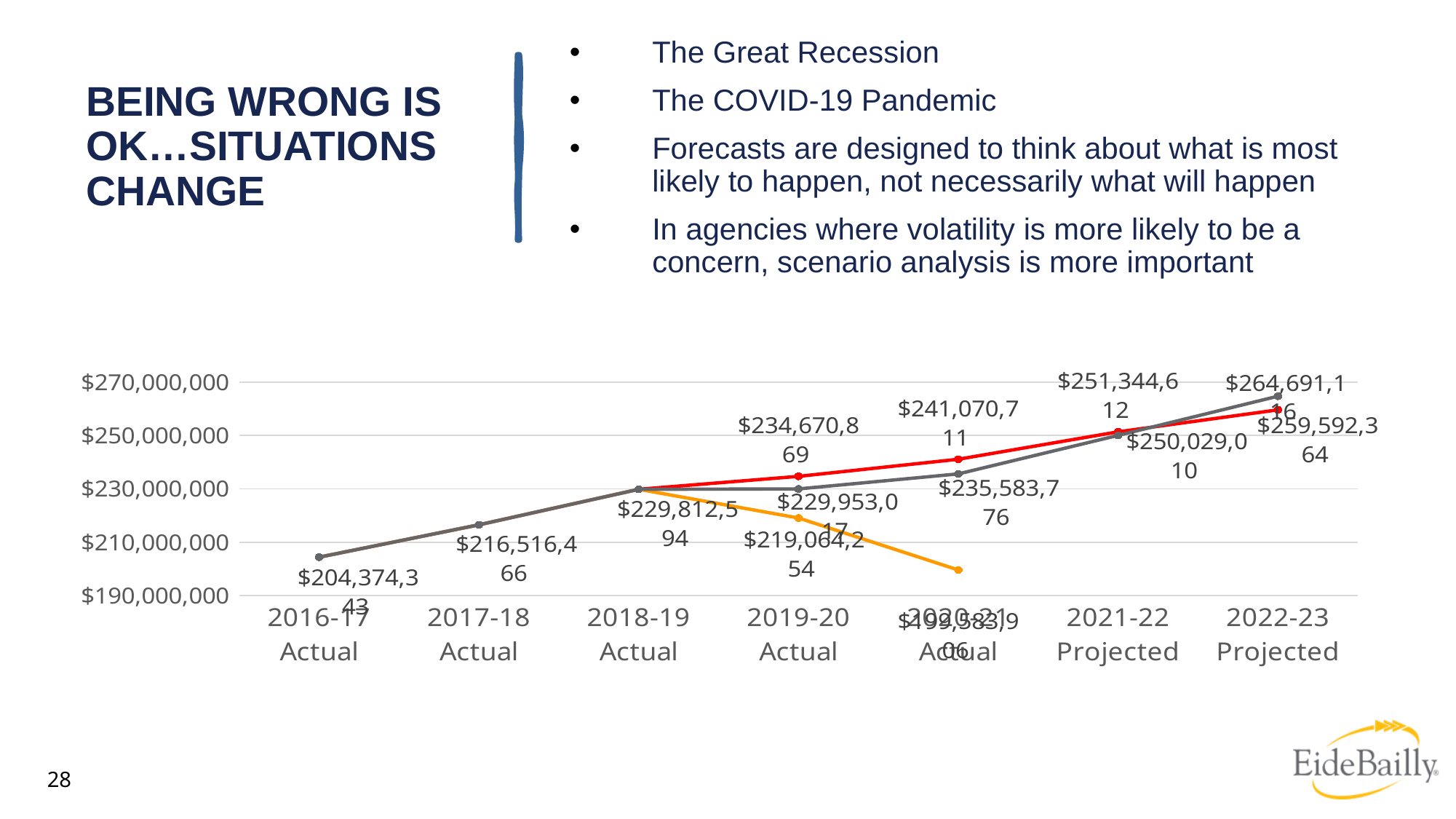
What is the value of the red line at 2019-20 Actual? $234,670,869 What is the value labelled for 2018-19 Actual, where the three lines meet? $229,812,594 Which category has the highest value on the gray line? 2022-23 Projected What is the value labelled for 2017-18 Actual? $216,516,466 How many lines (series) are plotted on the chart? 3 What kind of chart is shown on the slide? line chart How many fiscal-year categories are shown on the x axis of the chart? 7 What is the value labelled for 2016-17 Actual? $204,374,343 At 2021-22 Projected, which line has the larger value, the red line or the gray line? red line Is the value of the orange line at 2020-21 Actual greater or less than $210,000,000? less What is the value of the red line at 2021-22 Projected? $251,344,612 What is the difference between the 2017-18 Actual value and the 2016-17 Actual value? $12,142,123